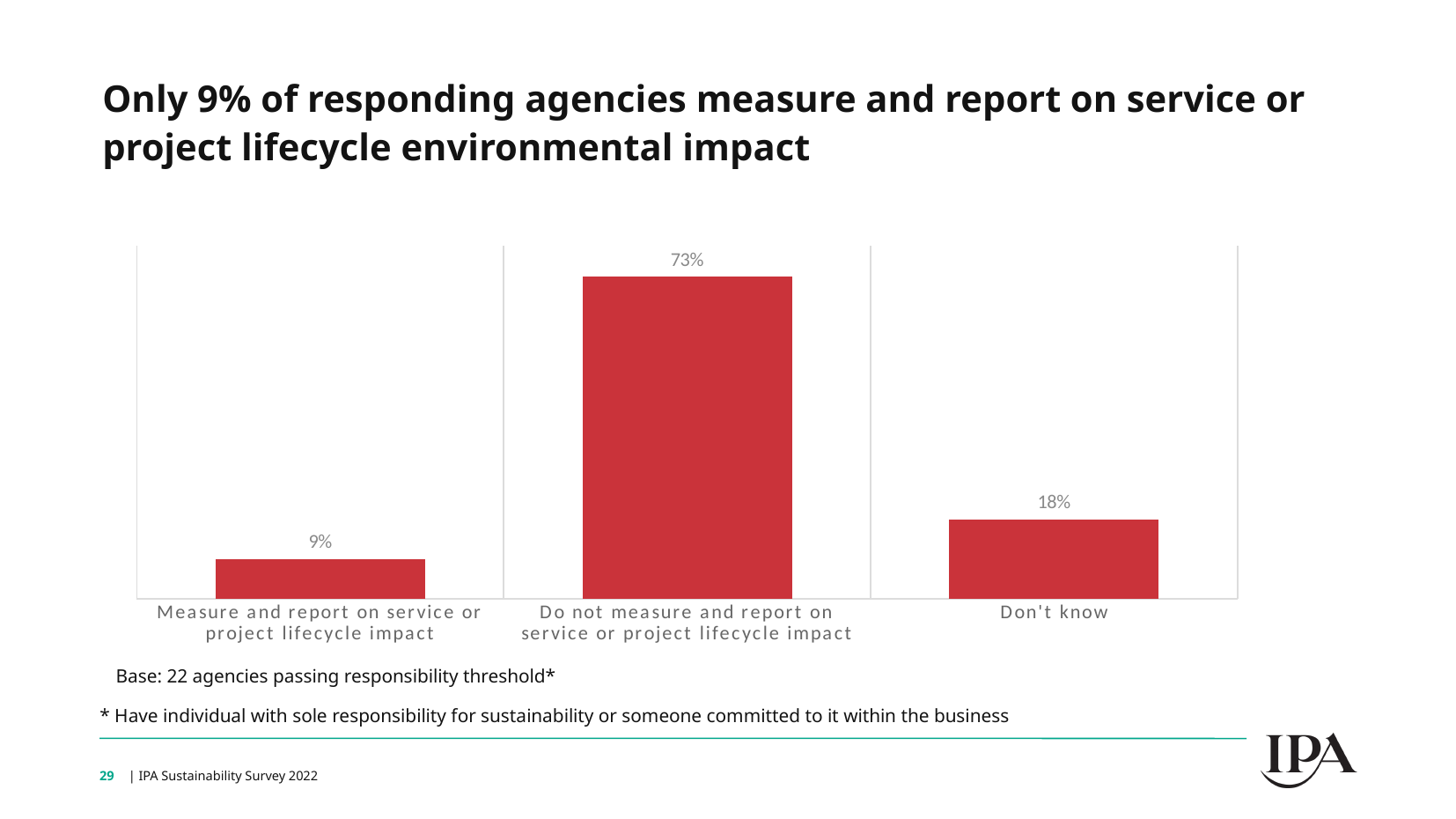
Which is larger: the value for 'Don't know' or the value for 'Measure and report on service or project lifecycle impact'? Don't know Which category has the highest value? Do not measure and report on service or project lifecycle impact How many categories are shown in the chart? 3 What is the difference between the 'Do not measure and report' value and the 'Don't know' value? 55% Which category has the lowest value? Measure and report on service or project lifecycle impact What is the difference between the 'Don't know' value and the 'Measure and report' value? 9% What percentage of agencies measure and report on service or project lifecycle impact? 9% What is the base size stated below the chart? 22 agencies passing responsibility threshold What type of chart is shown on the slide? Bar chart What percentage of agencies do not measure and report on service or project lifecycle impact? 73% What percentage of agencies answered 'Don't know'? 18% What colour are the bars in the chart? Red